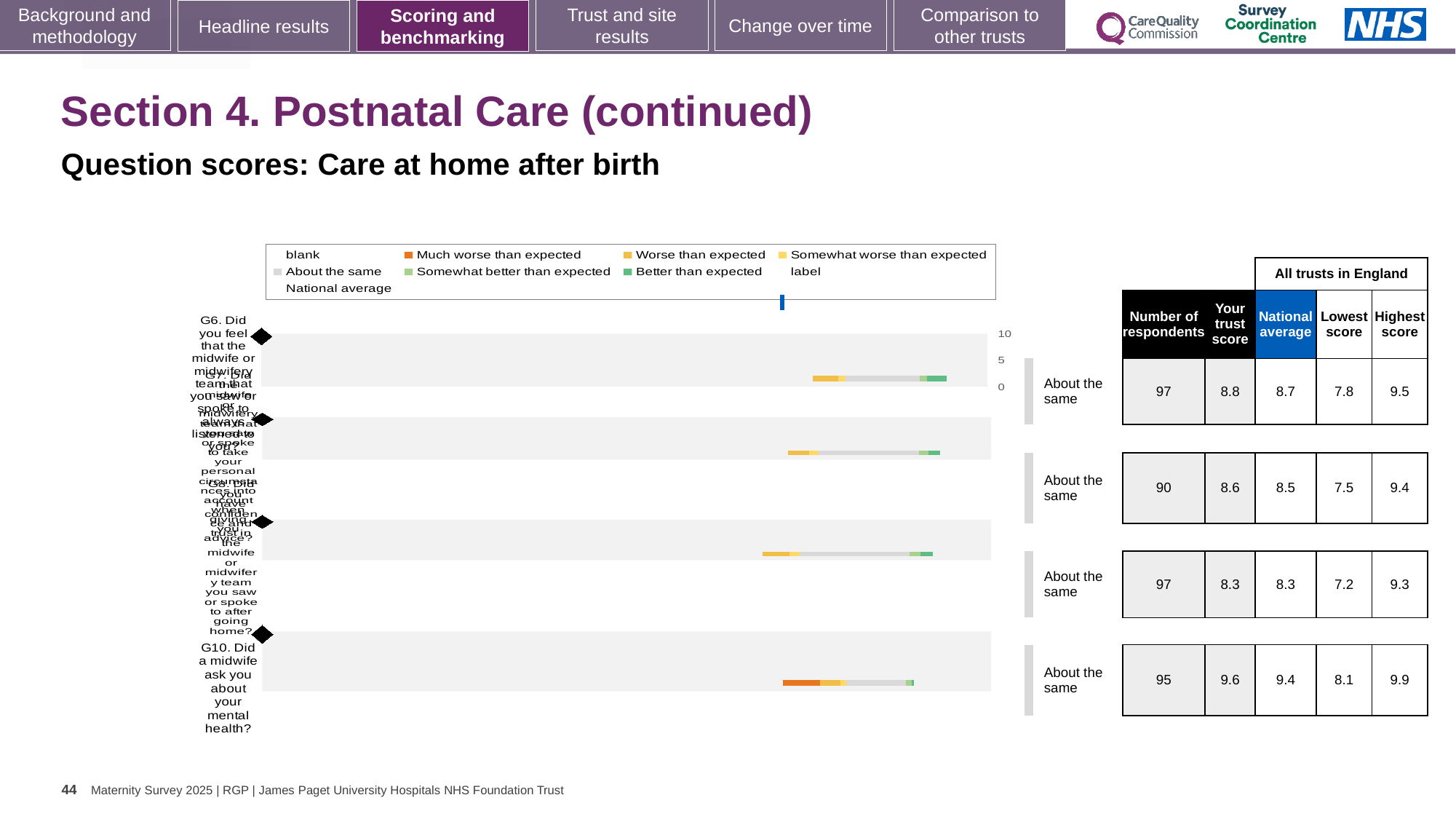
What is the highest score across all trusts in England for G10? 9.9 How many question rows are plotted in the chart? 4 How many respondents are listed for the first (top) question row? 97 What kind of chart is shown on the slide? bar chart How many respondents are listed for G10 (Did a midwife ask you about your mental health?)? 95 Which is larger: the lowest score for G10 (8.1) or the lowest score for the top question row (7.8)? G10 What is the lowest score across all trusts in England for G10? 8.1 What is the difference between the trust score and the national average for G10? 0.2 What benchmark category is shown next to each of the four question rows? About the same What is the 'Your trust score' for G10 (Did a midwife ask you about your mental health?)? 9.6 What is the national average for G10 (Did a midwife ask you about your mental health?)? 9.4 Which question row has the highest 'Your trust score'? G10